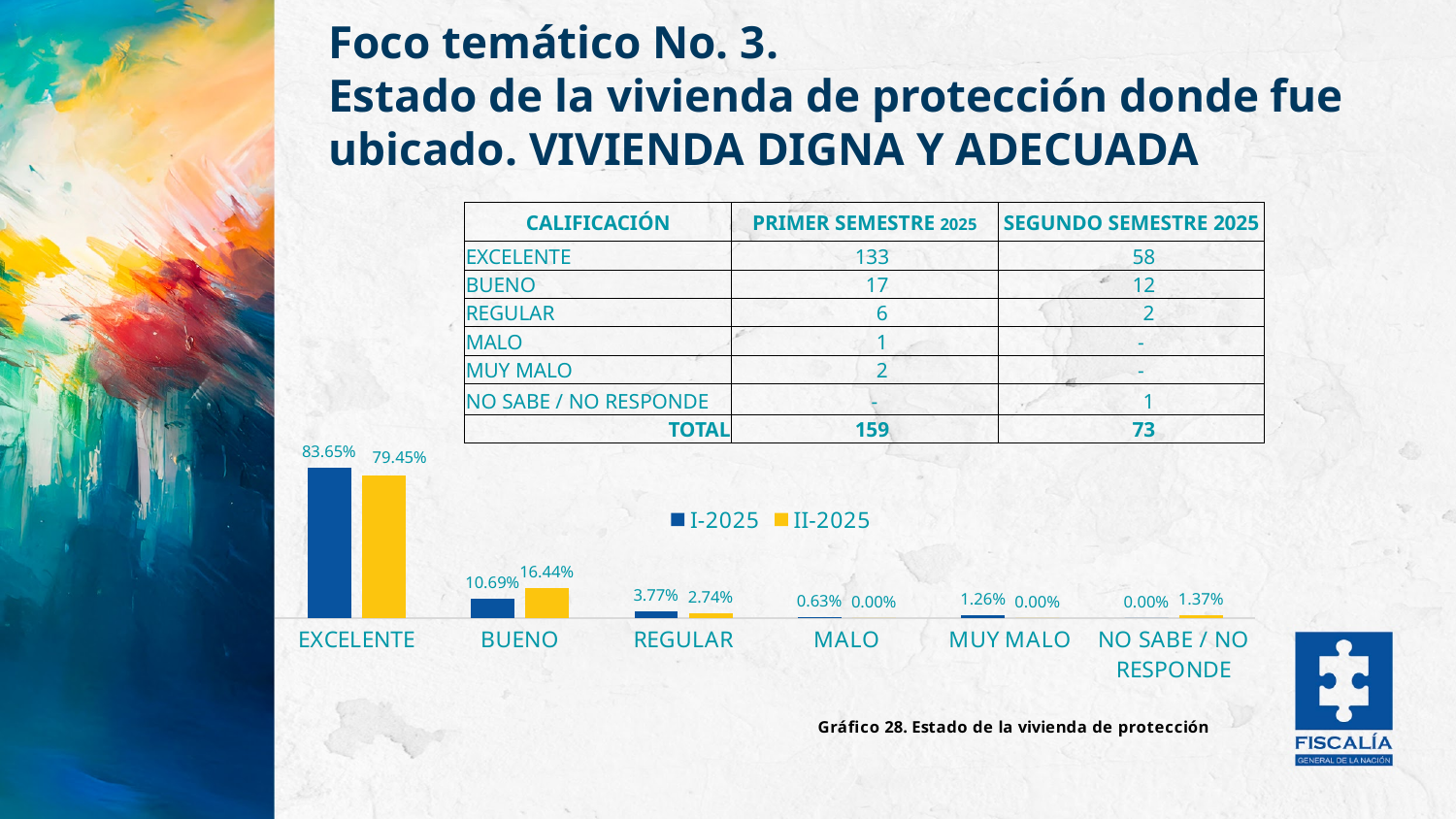
What is the I-2025 value for REGULAR in the chart? 3.77% What is the caption of the chart on the slide? Gráfico 28. Estado de la vivienda de protección How many series does the chart legend list? 2 What is the II-2025 value for NO SABE / NO RESPONDE in the chart? 1.37% What is the difference between the I-2025 and II-2025 values for EXCELENTE in the chart? 4.20% What kind of chart is shown on the slide? Bar chart Which category has the lowest I-2025 value in the chart? NO SABE / NO RESPONDE Which category has the highest I-2025 value in the chart? EXCELENTE What is the I-2025 value for EXCELENTE in the chart? 83.65% Which is larger for BUENO in the chart, the I-2025 value or the II-2025 value? II-2025 How many categories are shown on the x axis of the chart? 6 What is the II-2025 value for BUENO in the chart? 16.44%